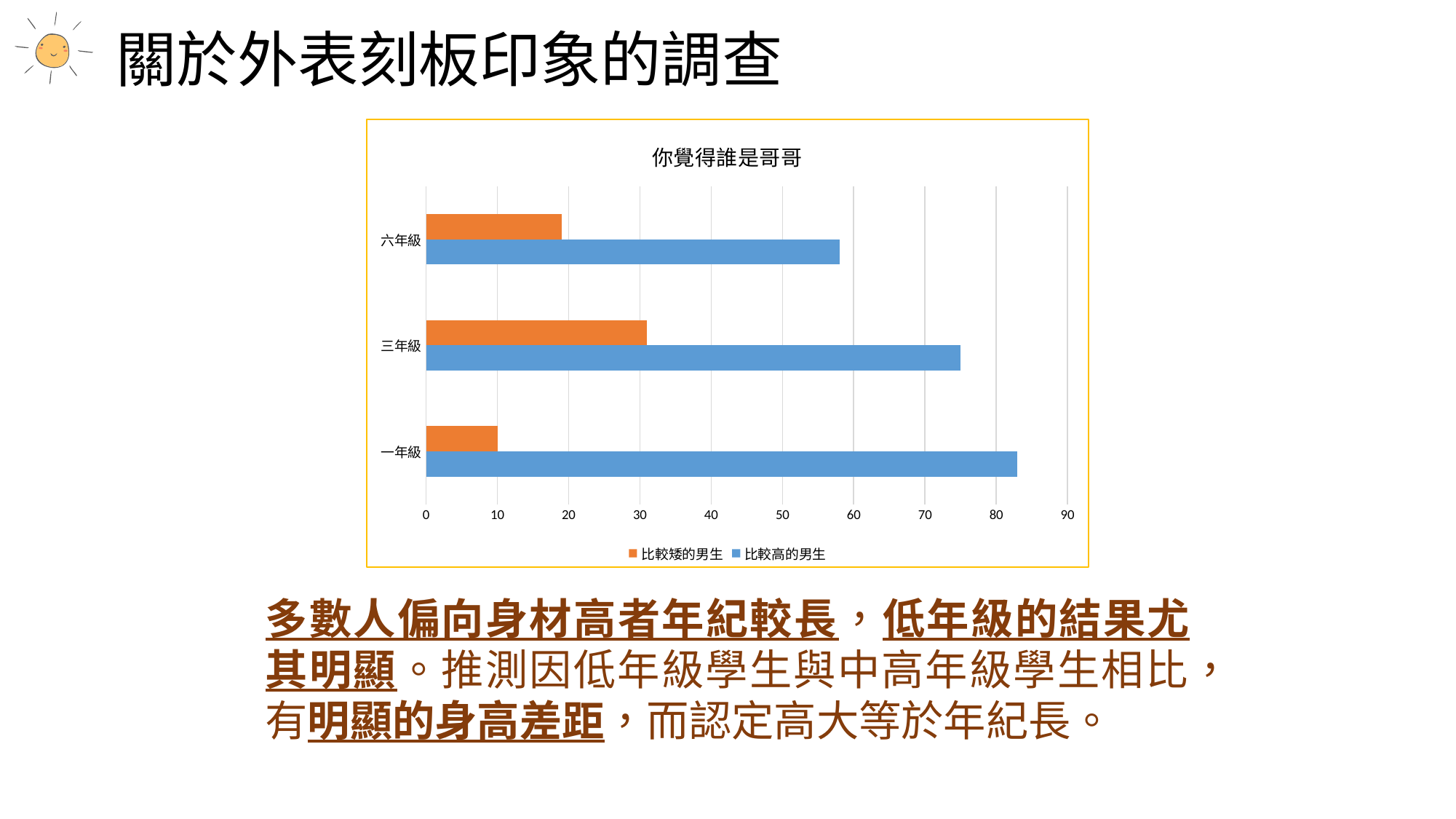
How many grade categories are shown on the chart? 3 What kind of chart is shown on the slide? bar chart Which grade has the lowest value for 比較高的男生? 六年級 Which grade has the highest value for 比較矮的男生? 三年級 What is the title of the chart? 你覺得誰是哥哥 Which grade has the lowest value for 比較矮的男生? 一年級 Is the value for 比較高的男生 in 一年級 greater or less than 80? greater How many series does the legend list? 2 For 三年級, which is larger: 比較矮的男生 or 比較高的男生? 比較高的男生 Is the value for 比較矮的男生 in 三年級 greater or less than 40? less Which grade has the highest value for 比較高的男生? 一年級 Is the value for 比較高的男生 in 六年級 greater or less than 50? greater